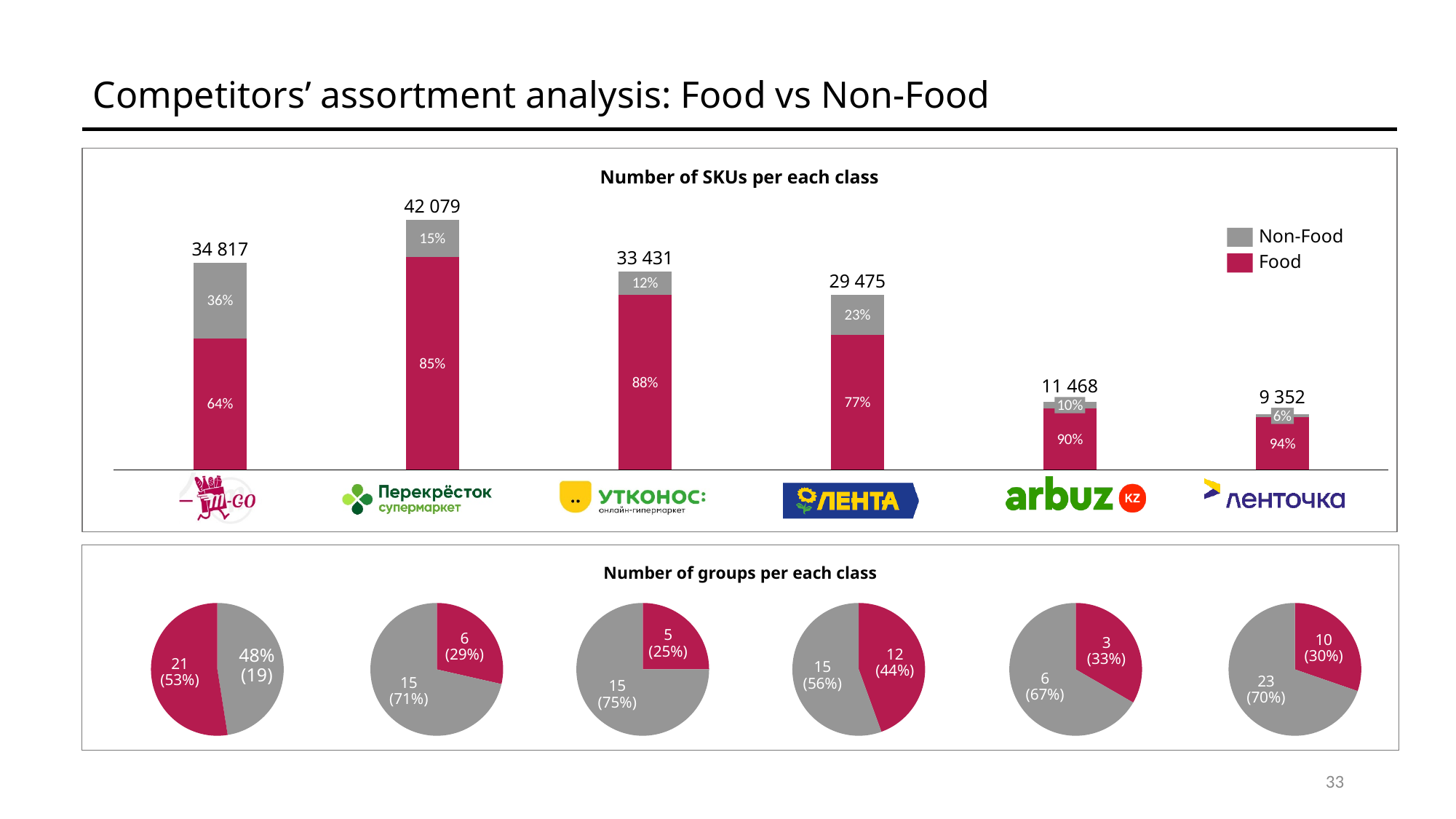
In the 'Number of SKUs per each class' chart, what share of Лента's SKUs is Non-Food? 23% How many pie charts are shown under 'Number of groups per each class'? 6 What kind of chart is 'Number of SKUs per each class'? Stacked bar chart In the 'Number of groups per each class' pie charts, what share of groups is Non-Food in the Ленточка pie (rightmost)? 70% In the 'Number of SKUs per each class' chart, which has more total SKUs, arbuz or Ленточка? arbuz In the 'Number of SKUs per each class' chart, which competitor has the lowest total number of SKUs? Ленточка In the 'Number of SKUs per each class' chart, what is the difference between the total SKUs of Утконос and Лента? 3 956 In the 'Number of SKUs per each class' chart, which competitor has the highest total number of SKUs? Перекрёсток How many series does the legend of the 'Number of SKUs per each class' chart list? 2 In the 'Number of SKUs per each class' chart, what share of Утконос's SKUs is Food? 88% In the 'Number of SKUs per each class' chart, what is the total number of SKUs for Перекрёсток? 42 079 In the 'Number of groups per each class' pie charts, how many Food groups does the Лента pie (fourth from left) show? 12